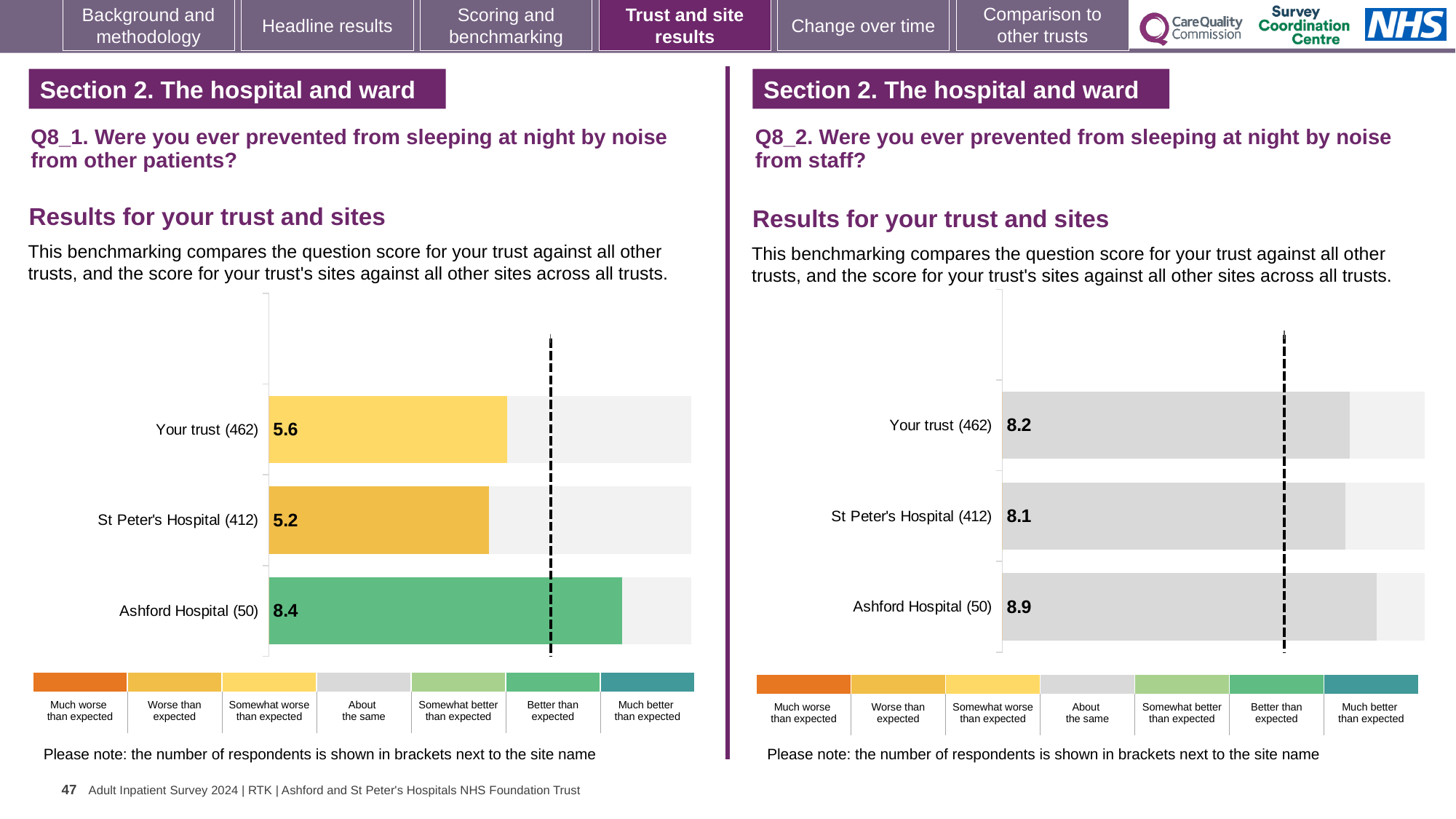
On the Q8_2 chart (noise from staff), what is the difference between the scores for Ashford Hospital and Your trust? 0.7 On the Q8_1 chart (noise from other patients), which site or trust has the lowest score? St Peter's Hospital On the Q8_1 chart (noise from other patients), which site or trust has the highest score? Ashford Hospital On the Q8_2 chart (noise from staff), what is the score for Ashford Hospital? 8.9 On the Q8_1 chart (noise from other patients), what is the score for Your trust? 5.6 How many bars are plotted on the Q8_1 chart (noise from other patients)? 3 On the Q8_2 chart (noise from staff), which site or trust has the lowest score? St Peter's Hospital On the Q8_2 chart (noise from staff), what is the score for Your trust? 8.2 On the Q8_1 chart (noise from other patients), what is the score for St Peter's Hospital? 5.2 On the Q8_1 chart (noise from other patients), what is the difference between the scores for Ashford Hospital and St Peter's Hospital? 3.2 Is the score for Your trust higher on the Q8_1 chart or on the Q8_2 chart? Q8_2 What type of chart is used on the Q8_2 chart (noise from staff)? Bar chart